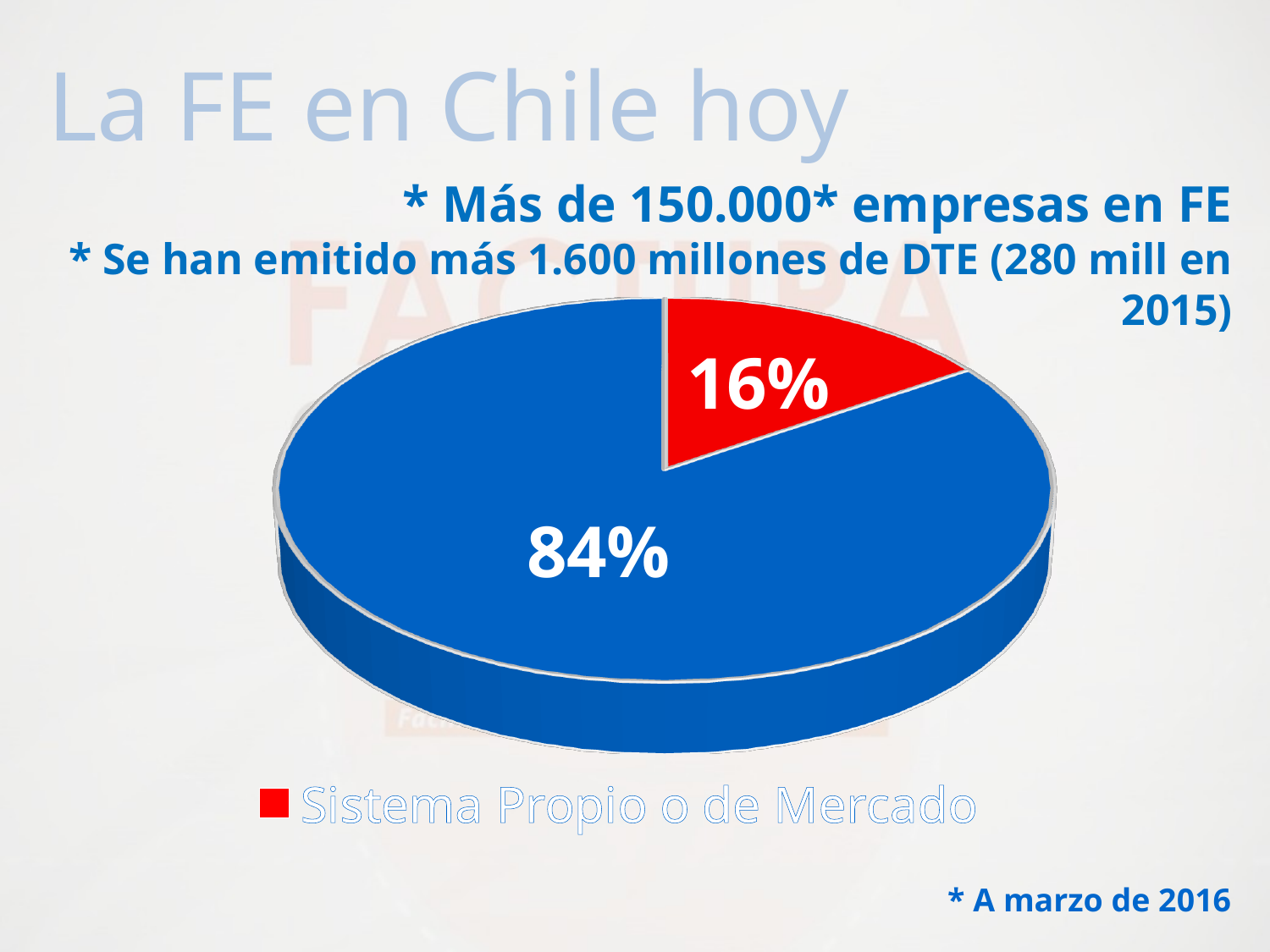
What kind of chart is shown on the slide? pie chart How many entries does the legend of the pie chart list? 1 Which slice of the pie chart is the smallest? Sistema Propio o de Mercado (16%) How many slices does the pie chart have? 2 What share of the pie does the "Sistema Propio o de Mercado" slice represent? 16% Is the blue slice or the red slice larger? the blue slice What percentage is shown on the blue slice of the pie chart? 84% What percentage is shown on the red slice of the pie chart? 16% Which slice of the pie chart is the largest? the blue slice (84%) What is the difference in percentage points between the blue slice and the red slice? 68 What colour is the "Sistema Propio o de Mercado" slice in the pie chart? red What is the legend entry shown below the pie chart? Sistema Propio o de Mercado